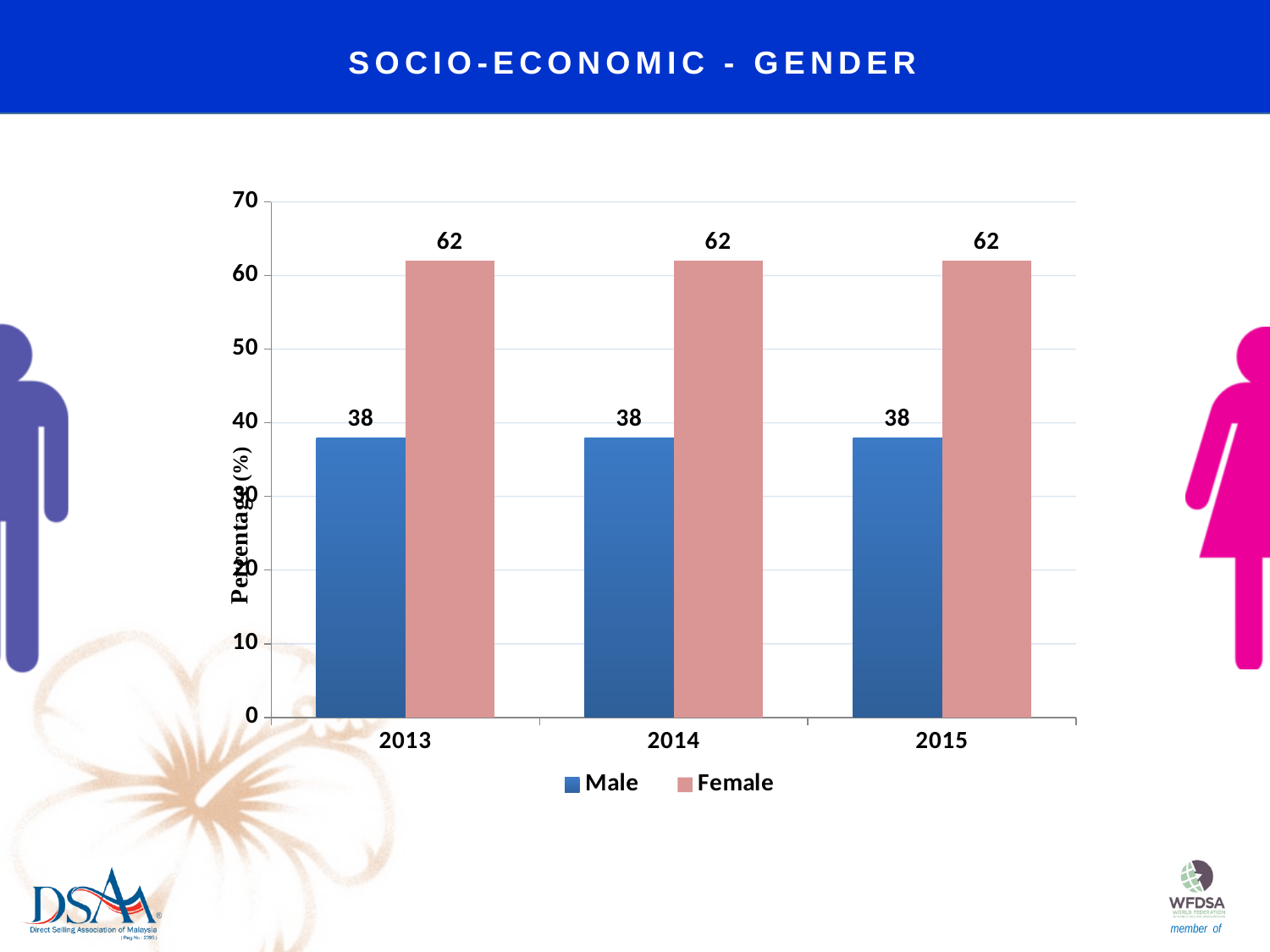
What is the difference between the Female and Male values in 2013? 24 What is the value for Female in 2014? 62 Is the value for Female in 2013 greater or less than 60? greater What kind of chart is shown on the slide? bar chart What is the value for Female in 2015? 62 How many series does the legend list? 2 What is the value for Male in 2013? 38 What is the label of the vertical axis? Percentage (%) Is the value for Male in 2015 greater or less than 40? less How many years are shown on the x axis? 3 Which series has the higher value in 2014, Male or Female? Female Do the Male values rise, fall or stay the same from 2013 to 2015? stay the same